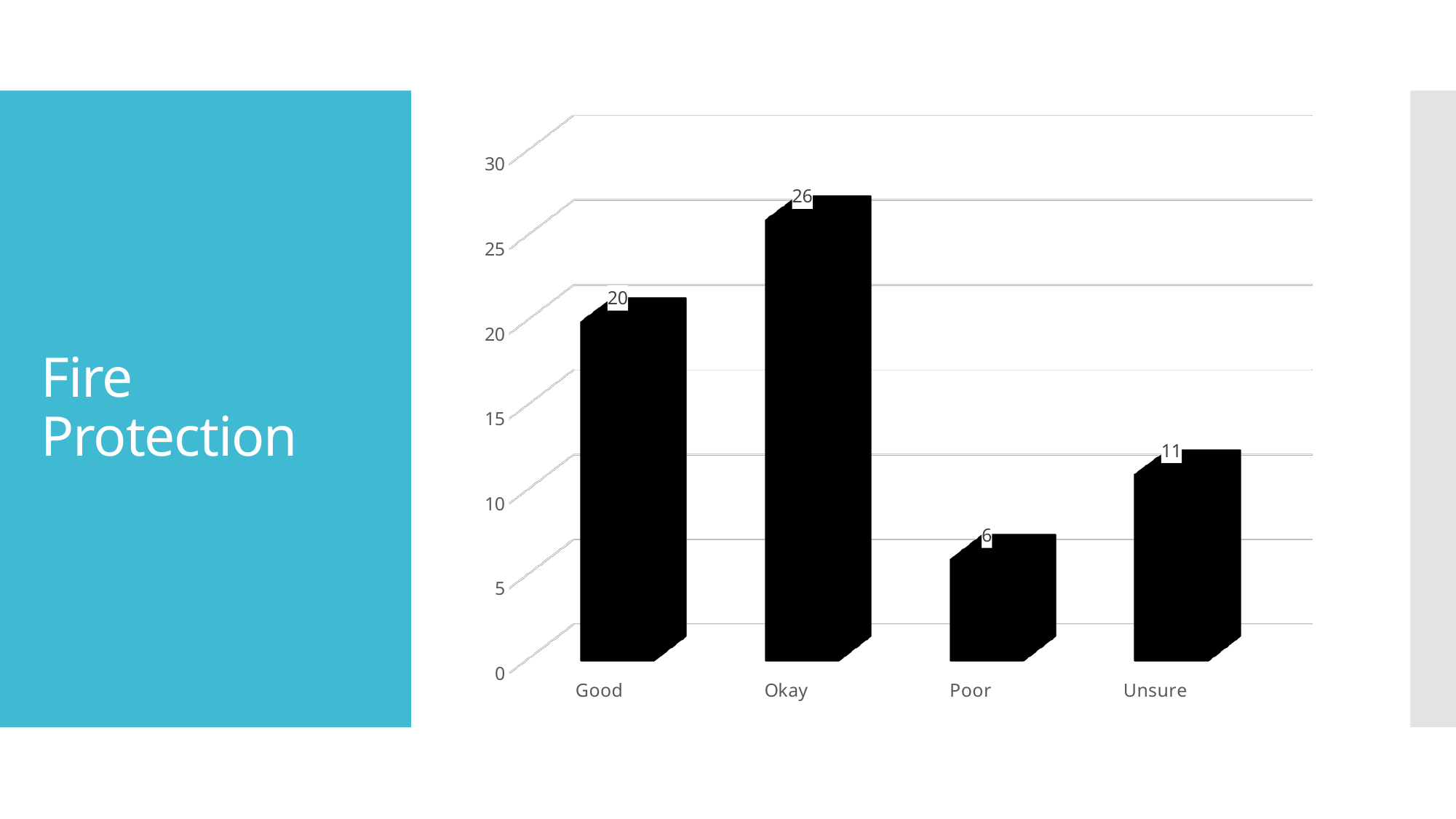
What is the value for Good? 20 What is the value for Unsure? 11 What is the difference between the values for Okay and Good? 6 What is the difference between the values for Unsure and Poor? 5 What is the value for Okay? 26 Which category has the highest value? Okay How many categories are shown on the x axis? 4 Which is larger, the value for Good or the value for Unsure? Good What kind of chart is shown on the slide? Bar chart What is the title text shown on the left of the slide? Fire Protection What is the value for Poor? 6 Which category has the lowest value? Poor